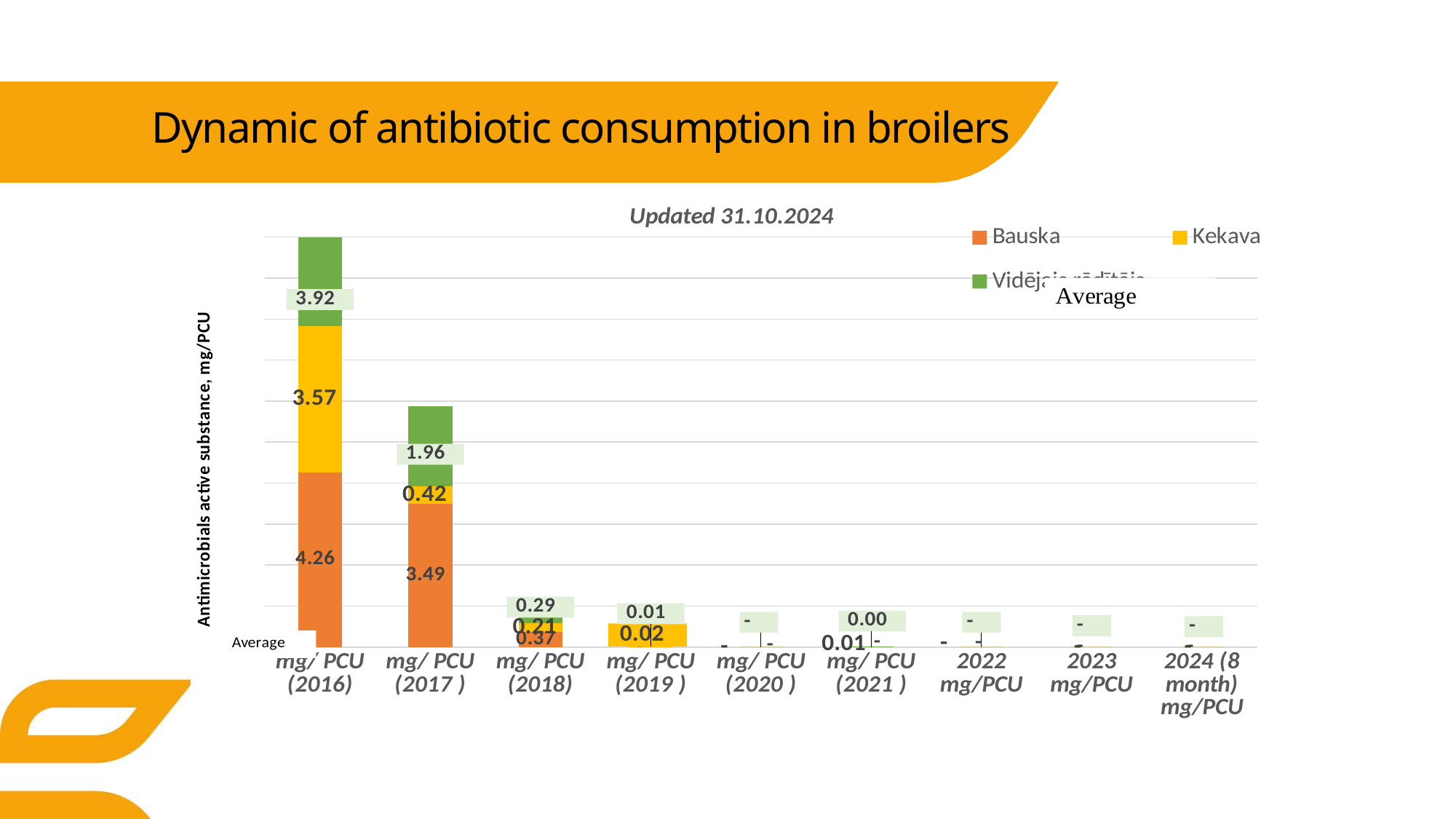
What is the difference between the Bauska values for 2016 and 2017? 0.77 What is the Bauska value for mg/PCU (2016)? 4.26 What is the Average value for mg/PCU (2021)? 0.00 In which year is the Bauska value highest? 2016 Which is larger in 2017, the Bauska value or the Kekava value? Bauska What is the Kekava value for mg/PCU (2018)? 0.21 What is the Kekava value for mg/PCU (2016)? 3.57 What is the Bauska value for mg/PCU (2017)? 3.49 What is the Average value for mg/PCU (2017)? 1.96 How many series does the legend list? 3 What type of chart is shown on the slide? stacked bar chart Do the Average values rise or fall from 2016 to 2018? fall